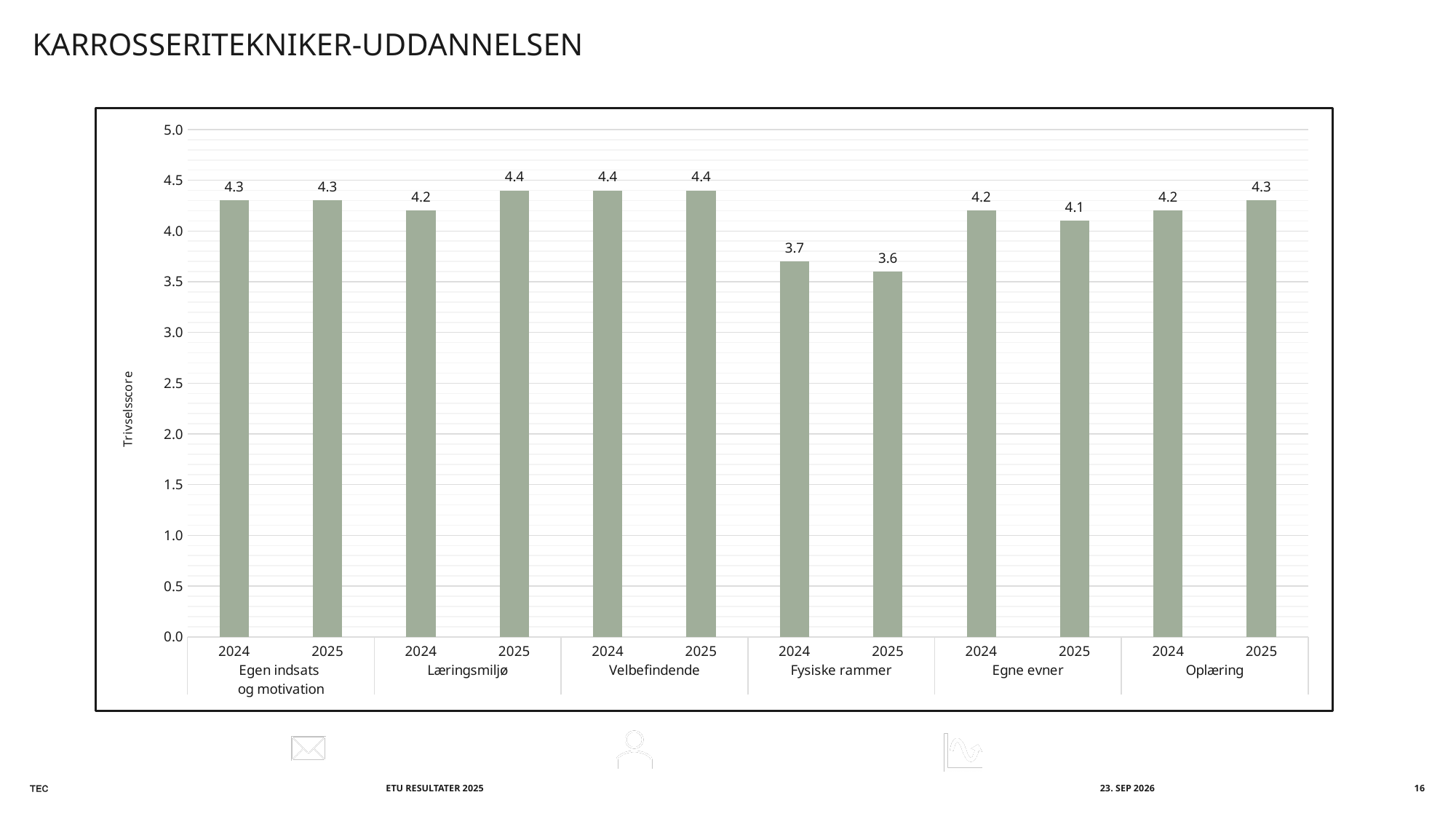
Which is larger, the 2024 or the 2025 Trivselsscore for Egne evner? 2024 What is the Trivselsscore for Læringsmiljø in 2025? 4.4 What is the difference between the 2024 and 2025 Trivselsscore for Fysiske rammer? 0.1 Is the 2025 value for Fysiske rammer greater or less than 4.0? less What is the Trivselsscore for Fysiske rammer in 2024? 3.7 What is the difference between the 2025 and 2024 Trivselsscore for Læringsmiljø? 0.2 What kind of chart is shown on the slide? Bar chart Which category has the lowest Trivselsscore in 2025? Fysiske rammer What is the Trivselsscore for Oplæring in 2024? 4.2 What is the label of the vertical axis? Trivselsscore What is the Trivselsscore for Egne evner in 2025? 4.1 How many bars are plotted in the chart? 12